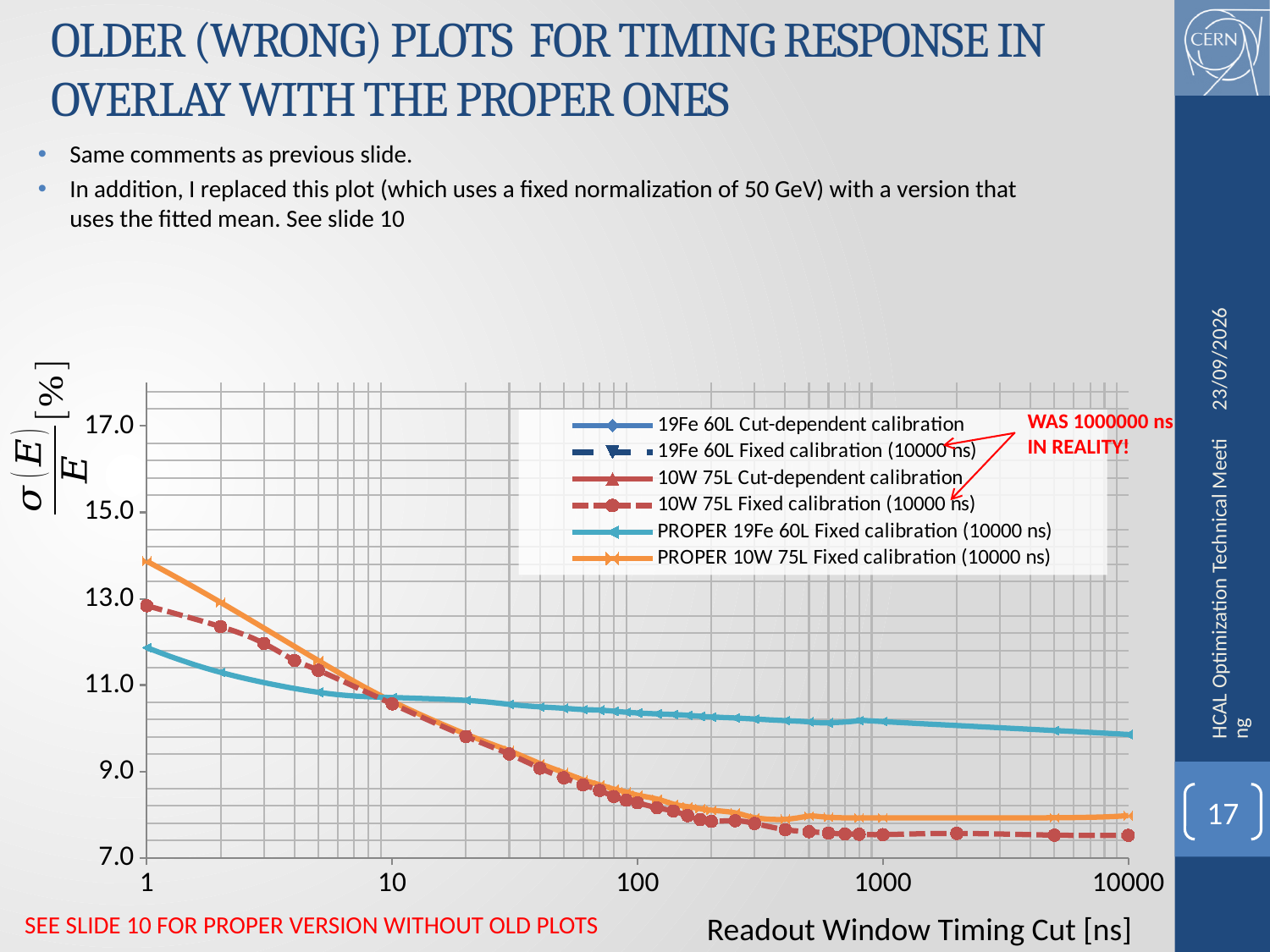
Does the PROPER 10W 75L Fixed calibration (10000 ns) series rise or fall as the timing cut increases from 1 ns to 100 ns? fall Is the value of the PROPER 19Fe 60L Fixed calibration (10000 ns) series at 1 ns greater or less than 11.0? greater Is the value of the PROPER 10W 75L Fixed calibration (10000 ns) series at 1 ns greater or less than 13.0? greater Is the value of the 10W 75L Fixed calibration (10000 ns) series at 100 ns greater or less than 9.0? less How many series does the chart legend list? 6 What kind of chart is shown on the slide? line chart At 1 ns, which series has the higher value: PROPER 10W 75L Fixed calibration (10000 ns) or PROPER 19Fe 60L Fixed calibration (10000 ns)? PROPER 10W 75L Fixed calibration (10000 ns) What does the red annotation next to the chart legend say? WAS 1000000 ns IN REALITY! At 10000 ns, which series has the higher value: PROPER 19Fe 60L Fixed calibration (10000 ns) or PROPER 10W 75L Fixed calibration (10000 ns)? PROPER 19Fe 60L Fixed calibration (10000 ns) What is the title of the x axis of the chart? Readout Window Timing Cut [ns]